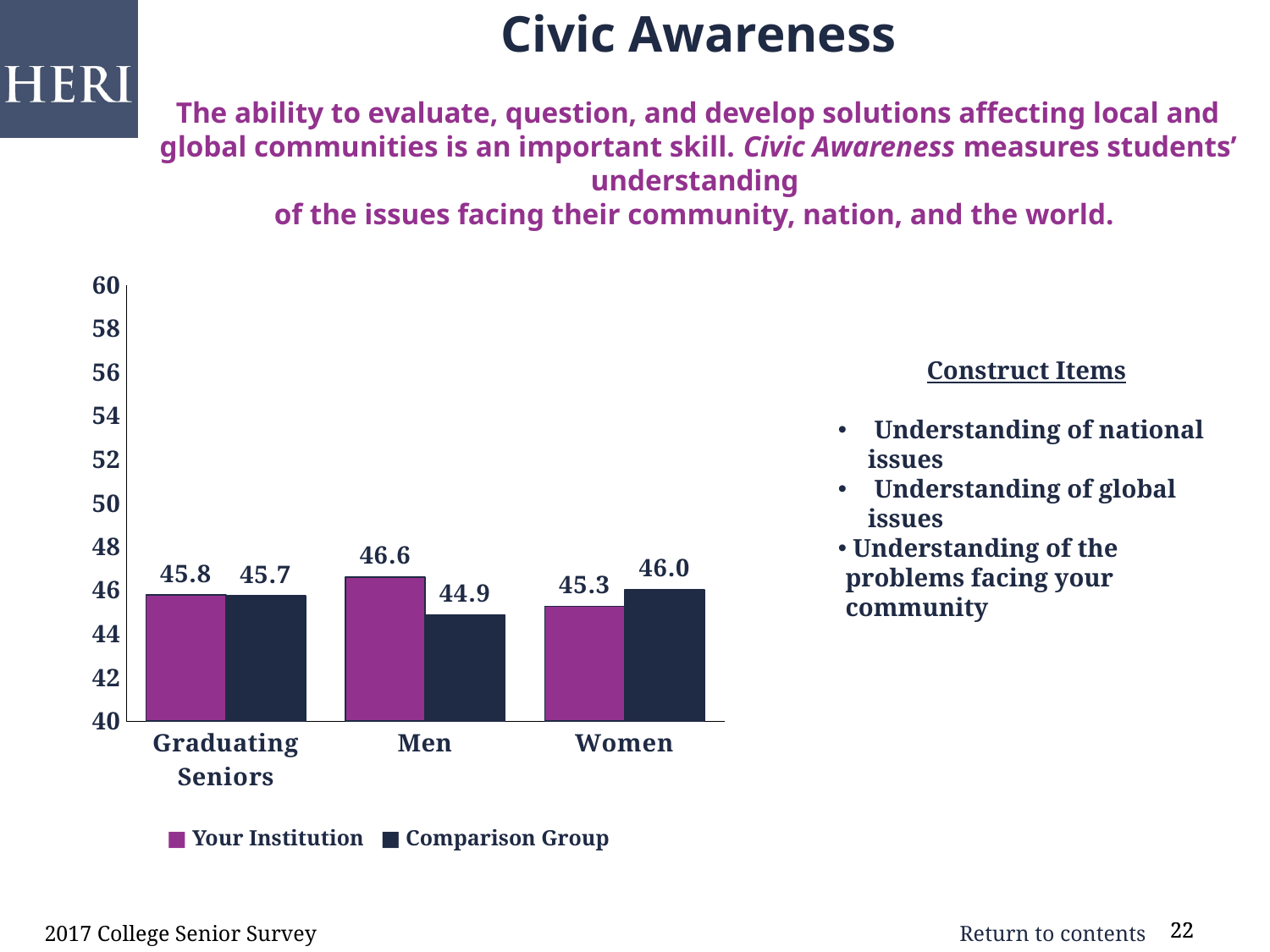
What is the Your Institution value for Graduating Seniors? 45.8 Which category has the lowest Comparison Group value? Men For Women, which is larger: the Your Institution value or the Comparison Group value? Comparison Group Which category has the highest Your Institution value? Men How many categories are shown on the x axis? 3 What is the Comparison Group value for Women? 46.0 What is the Comparison Group value for Men? 44.9 What is the Your Institution value for Men? 46.6 What kind of chart is shown on the slide? Bar chart What is the difference between the Your Institution and Comparison Group values for Men? 1.7 How many series does the legend list? 2 What is the title of the slide containing the chart? Civic Awareness